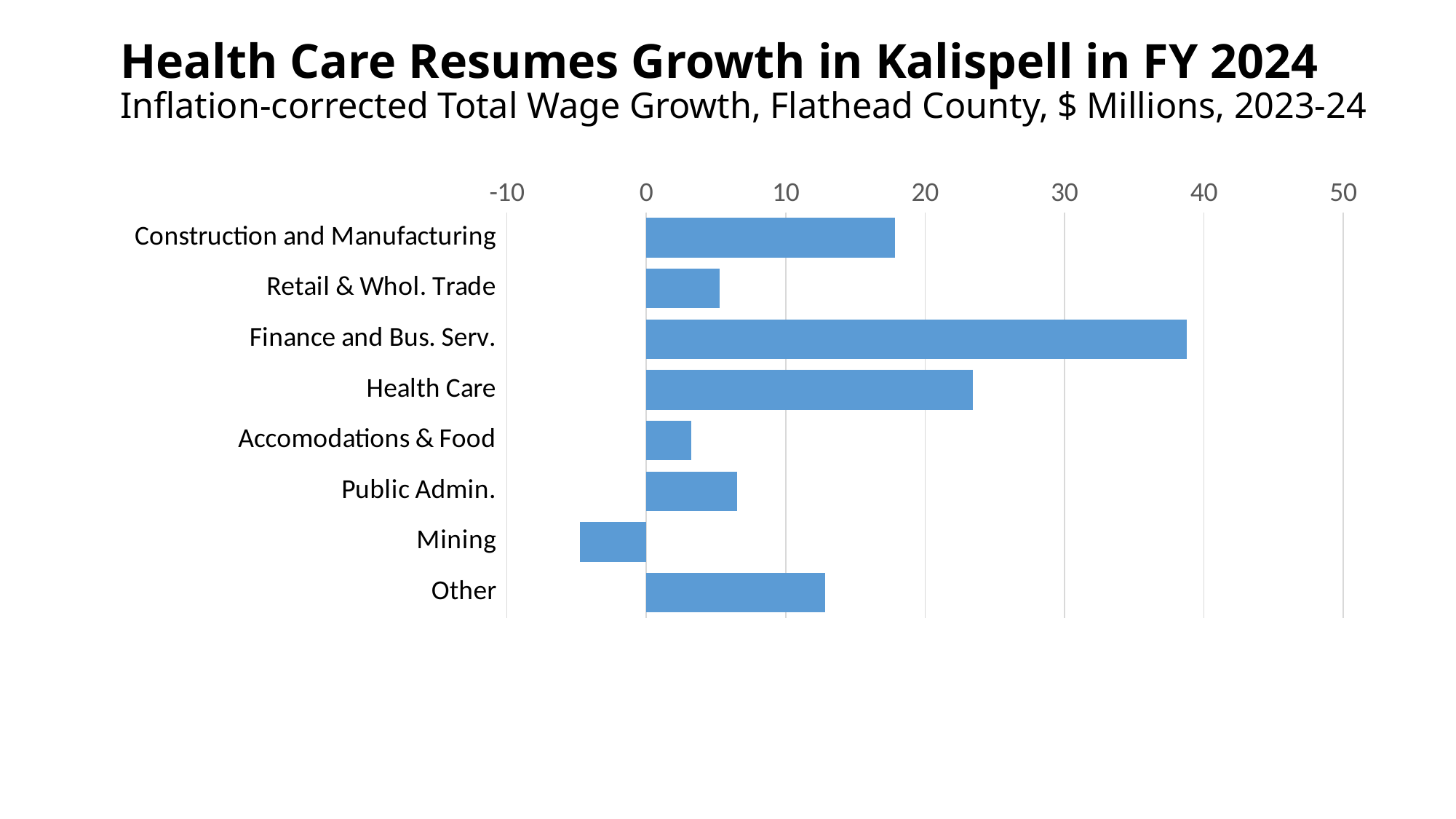
Is the value for Other greater or less than 10? greater Is the value for Health Care greater or less than 20? greater Which is larger, the value for Health Care or the value for Construction and Manufacturing? Health Care How many categories are plotted in the chart? 8 Which is larger, the value for Public Admin. or the value for Accomodations & Food? Public Admin. What kind of chart is shown on the slide? bar chart Which category has the highest inflation-corrected total wage growth? Finance and Bus. Serv. Which category has the lowest inflation-corrected total wage growth? Mining What is the title of the chart on the slide? Health Care Resumes Growth in Kalispell in FY 2024 Which category is the only one with negative wage growth? Mining Is the value for Construction and Manufacturing greater or less than 20? less